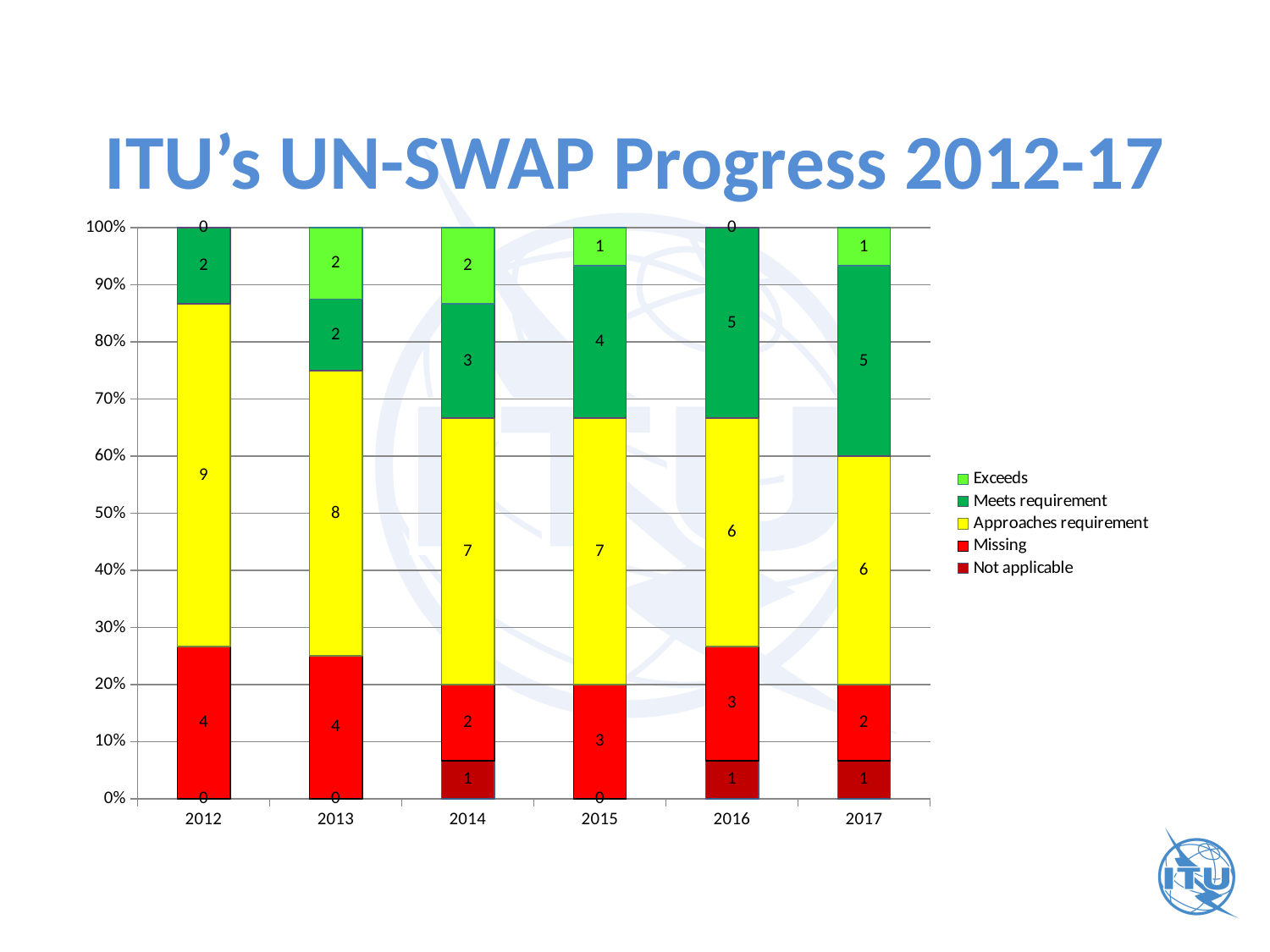
What is the value for Approaches requirement in 2012? 9 What is the value for Exceeds in 2013? 2 Which is larger, the Meets requirement value in 2016 or in 2014? 2016 What kind of chart is shown on the slide? Stacked bar chart How many years are shown on the x axis? 6 What is the value for Meets requirement in 2017? 5 What is the total of the stacked bar for 2013? 16 How many series does the legend list? 5 What is the value for Missing in 2015? 3 What is the difference between the Approaches requirement values in 2012 and 2017? 3 In which year is the Missing value lowest? 2014 and 2017 In which year is the Approaches requirement value highest? 2012